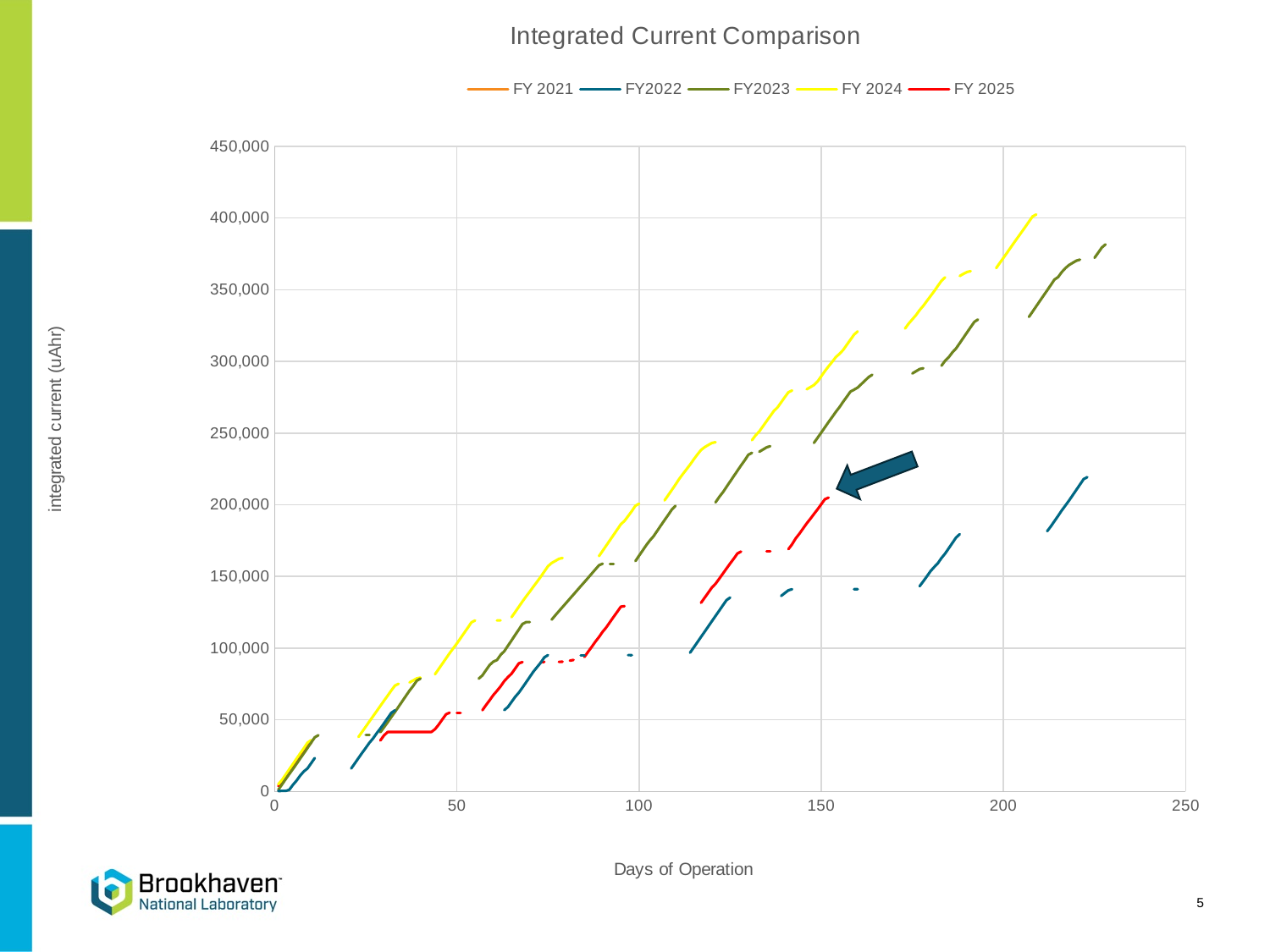
What is the label on the x axis of the chart? Days of Operation Is the value for FY 2025 at around 150 days of operation greater or less than 150,000? greater Is the value for FY2023 at around 100 days of operation greater or less than 100,000? greater How many series does the legend list? 5 Which series reaches the highest integrated current on the chart? FY 2024 Is the highest value reached by FY 2024 greater or less than 350,000? greater At around 150 days of operation, which series has the larger value: FY 2024 or FY2022? FY 2024 Do the values for each series rise or fall as the days of operation increase? rise At around 220 days of operation, which series has the larger value: FY2022 or FY2023? FY2023 What is the title of the chart? Integrated Current Comparison What kind of chart is shown on the slide? line chart